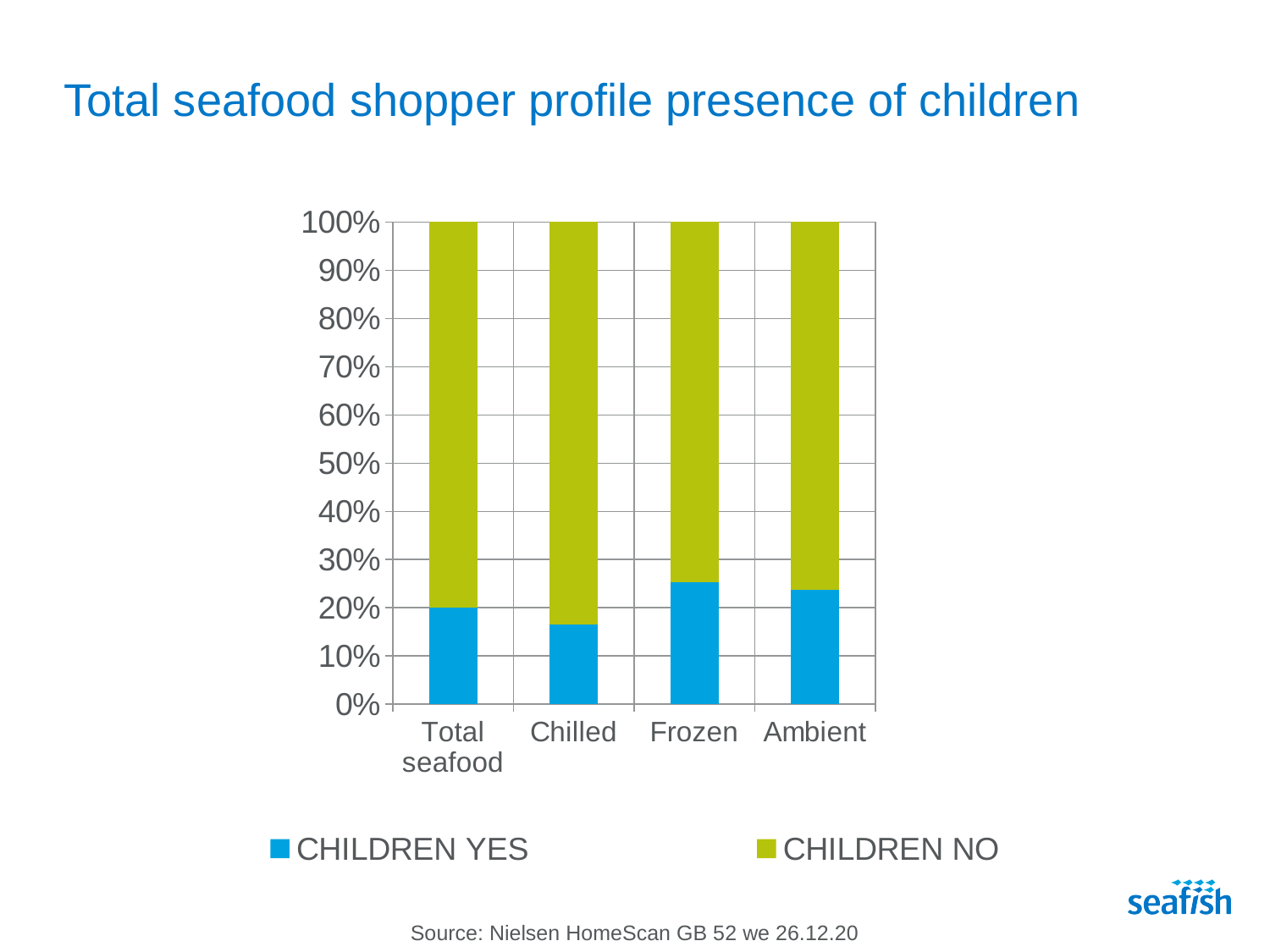
How many categories are shown on the x axis? 4 Is the CHILDREN YES value for Frozen greater or less than 20%? greater Which has the larger CHILDREN YES share, Frozen or Chilled? Frozen What is the title of the chart? Total seafood shopper profile presence of children Which category has the highest CHILDREN YES share? Frozen Which category has the lowest CHILDREN YES share? Chilled What kind of chart is shown on the slide? bar chart How many series does the legend list? 2 Which colour represents CHILDREN NO in the legend? green Is the CHILDREN NO value for Ambient greater or less than 70%? greater Is the CHILDREN YES value for Frozen greater or less than 30%? less